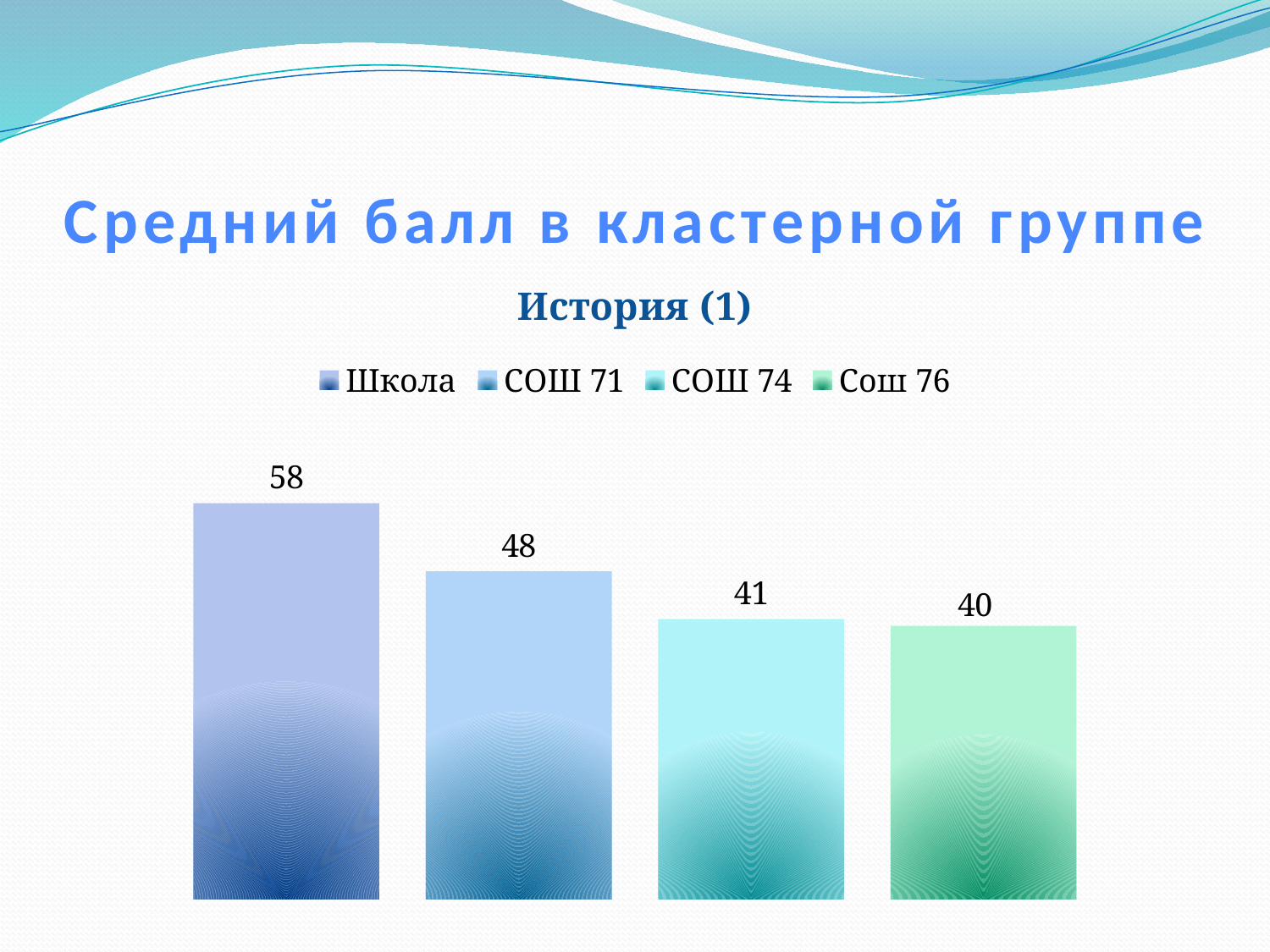
How many bars are shown in the chart? 4 Which category has the lowest value? Сош 76 What kind of chart is shown on the slide? Bar chart What is the value for СОШ 74? 41 What is the difference between the values for Школа and СОШ 71? 10 Which is larger, the value for СОШ 71 or the value for СОШ 74? СОШ 71 What is the value for СОШ 71? 48 Which category has the highest value? Школа What is the value for Сош 76? 40 What is the value for Школа? 58 What is the difference between the values for СОШ 74 and Сош 76? 1 What is the title of the chart? История (1)